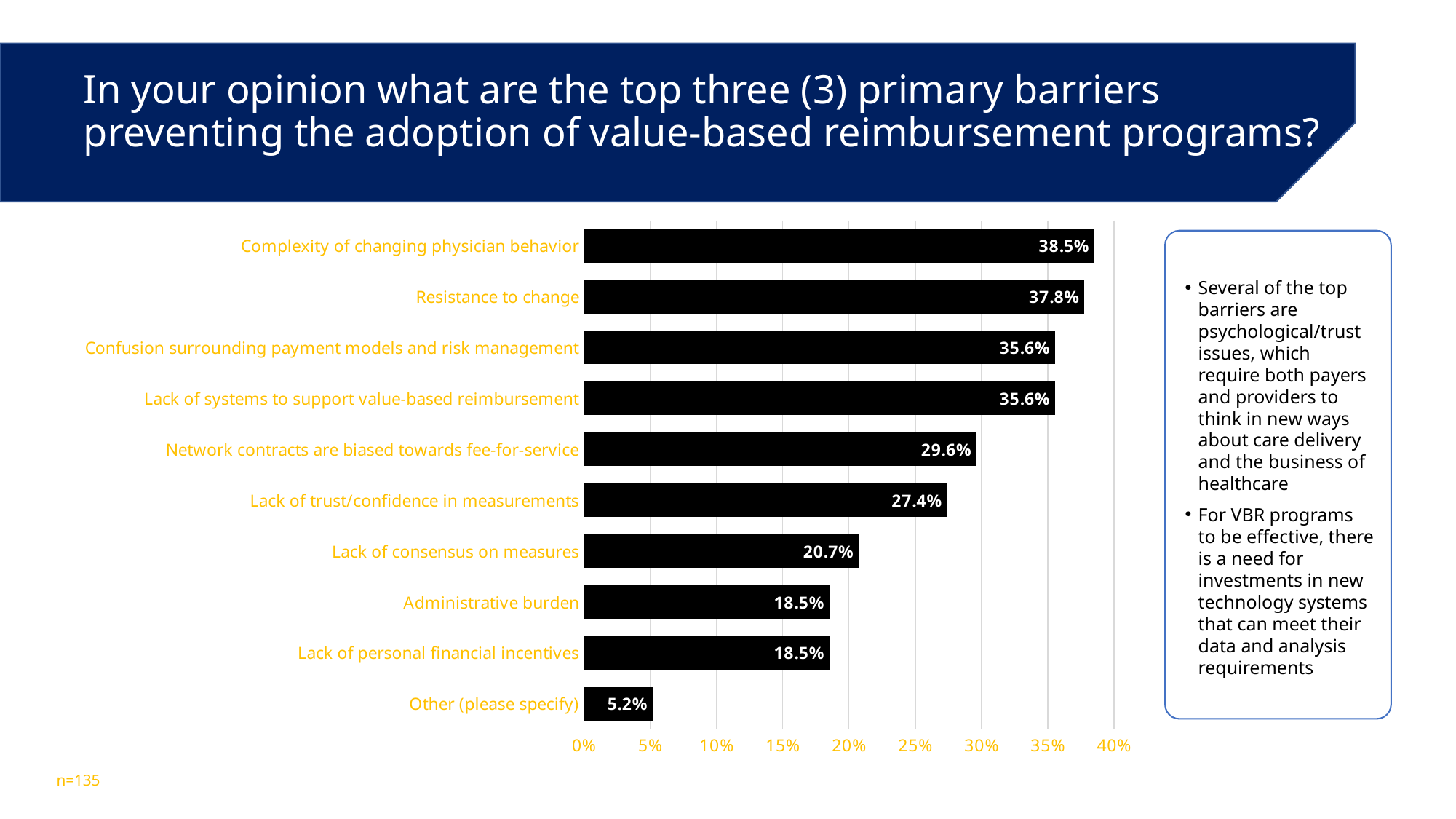
What sample size (n) is noted on the slide? n=135 Is the value for 'Confusion surrounding payment models and risk management' greater or less than 30%? greater What is the difference between the values for 'Resistance to change' and 'Lack of consensus on measures'? 17.1% Which barrier has the highest percentage in the chart? Complexity of changing physician behavior Which is larger: the value for 'Lack of trust/confidence in measurements' or the value for 'Administrative burden'? Lack of trust/confidence in measurements What is the value shown for 'Network contracts are biased towards fee-for-service'? 29.6% What kind of chart is shown on the slide? Bar chart What is the value shown for 'Lack of personal financial incentives'? 18.5% What percentage of respondents cited 'Complexity of changing physician behavior' as a primary barrier? 38.5% What is the value shown for 'Other (please specify)'? 5.2% How many barrier categories are shown in the chart? 10 Which category has the lowest percentage in the chart? Other (please specify)